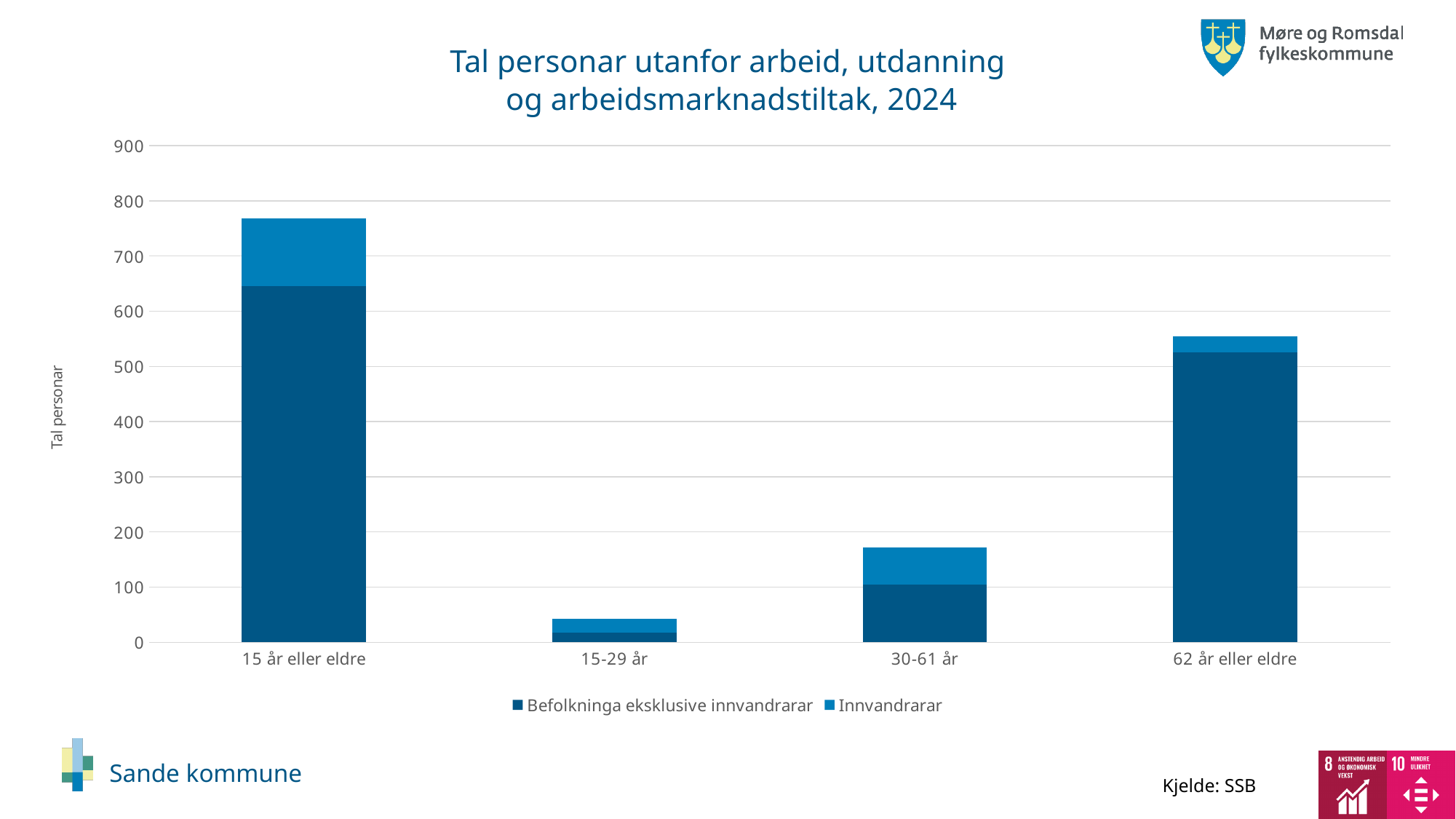
What is the label on the y axis? Tal personar How many age categories are shown on the x axis? 4 What kind of chart is shown on the slide? bar chart Which age category has the tallest stacked bar? 15 år eller eldre What is the title of the chart? Tal personar utanfor arbeid, utdanning og arbeidsmarknadstiltak, 2024 Is the total stacked value for 15 år eller eldre greater or less than 700? greater Which age category has the shortest stacked bar? 15-29 år Which stacked bar is taller: 62 år eller eldre or 30-61 år? 62 år eller eldre Is the Befolkninga eksklusive innvandrarar value for 62 år eller eldre greater or less than 400? greater Is the total stacked value for 30-61 år greater or less than 200? less How many series does the legend list? 2